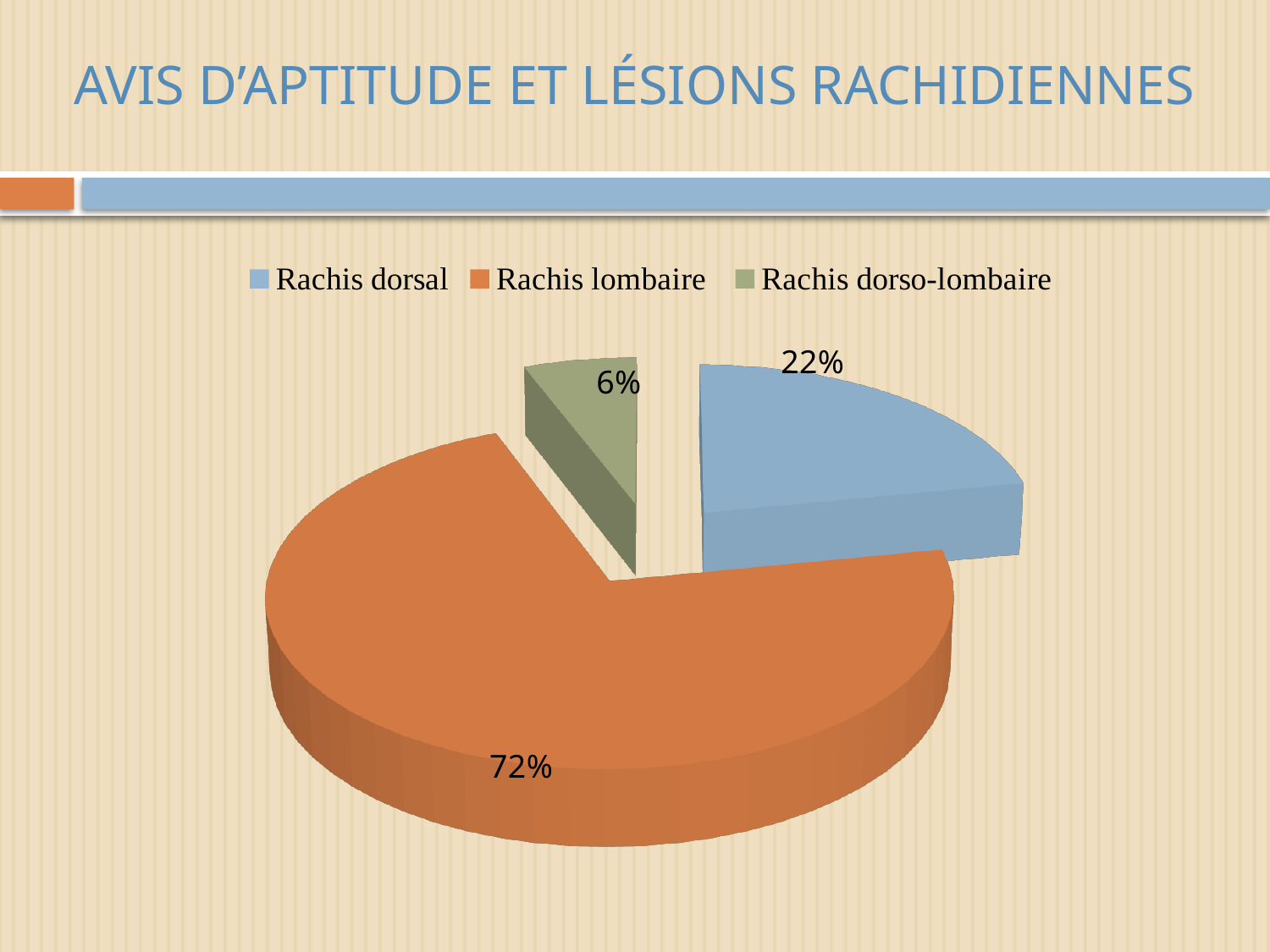
What is the difference in percentage points between Rachis dorsal and Rachis dorso-lombaire? 16 What type of chart is shown on the slide? Pie chart What colour is the slice for Rachis dorsal? Blue Which category has the largest slice of the pie? Rachis lombaire Which is larger, the slice for Rachis dorsal or the slice for Rachis dorso-lombaire? Rachis dorsal What share of the pie does Rachis dorso-lombaire represent? 6% What is the difference in percentage points between Rachis lombaire and Rachis dorsal? 50 How many categories does the pie chart show? 3 Which category has the smallest slice of the pie? Rachis dorso-lombaire What share of the pie does Rachis lombaire represent? 72% What share of the pie does Rachis dorsal represent? 22% What is the title of the slide containing the chart? AVIS D'APTITUDE ET LÉSIONS RACHIDIENNES